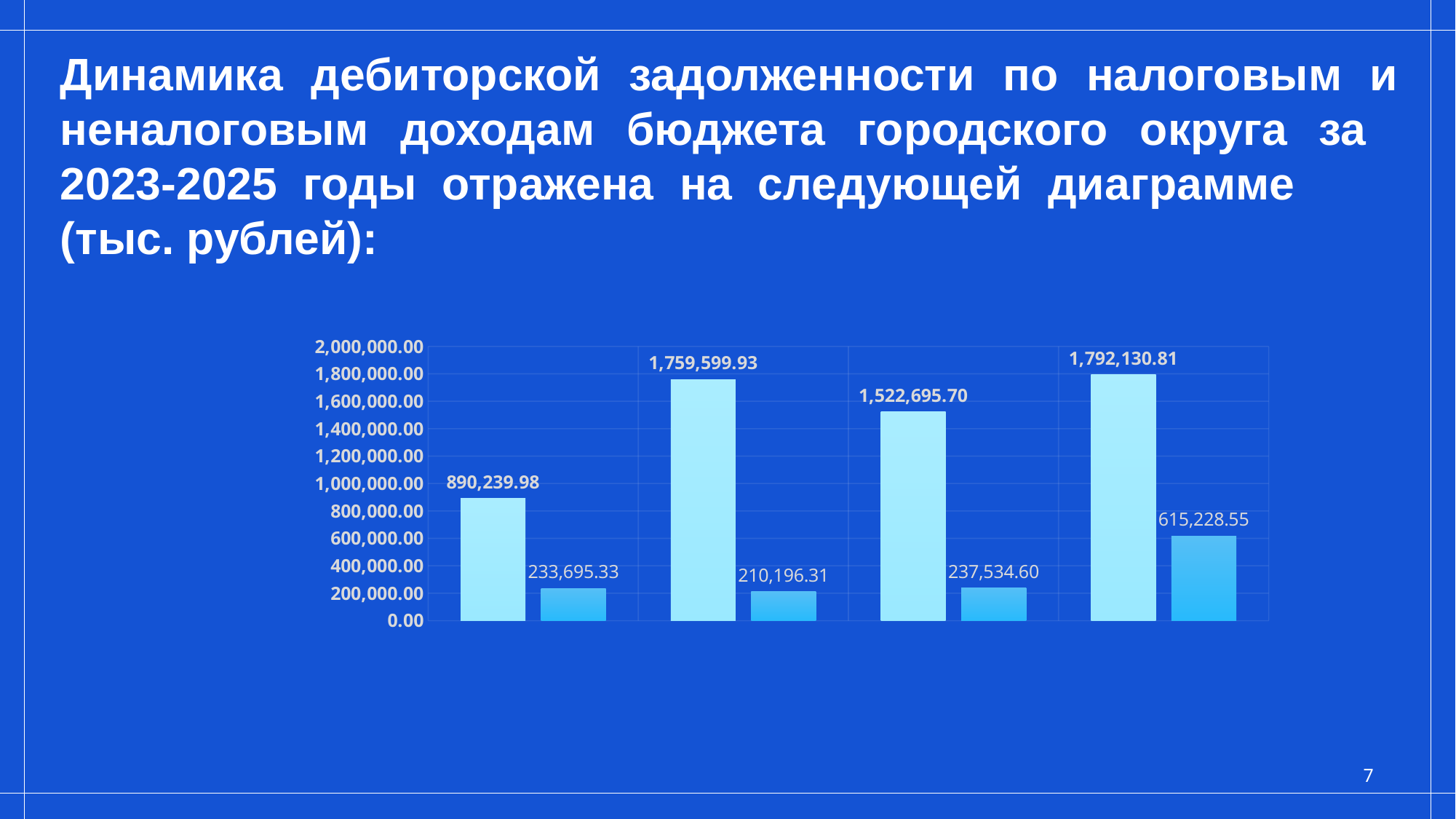
What type of chart is shown on the slide? bar chart Which group has the highest light blue bar? the fourth group (1,792,130.81) What is the value of the light blue bar in the first group? 890,239.98 Is the value of the darker blue bar in the third group greater or less than 400,000.00? less What is the highest value shown on the vertical axis? 2,000,000.00 How many groups of bars are plotted in the chart? 4 What is the value of the darker blue bar in the fourth group? 615,228.55 What is the difference between the darker blue bars in the fourth and first groups? 381,533.22 What is the value of the light blue bar in the third group? 1,522,695.70 Which is larger: the light blue bar in the second group or the light blue bar in the fourth group? the fourth group (1,792,130.81) Which group has the lowest darker blue bar? the second group (210,196.31) What is the difference between the light blue bars in the fourth and third groups? 269,435.11